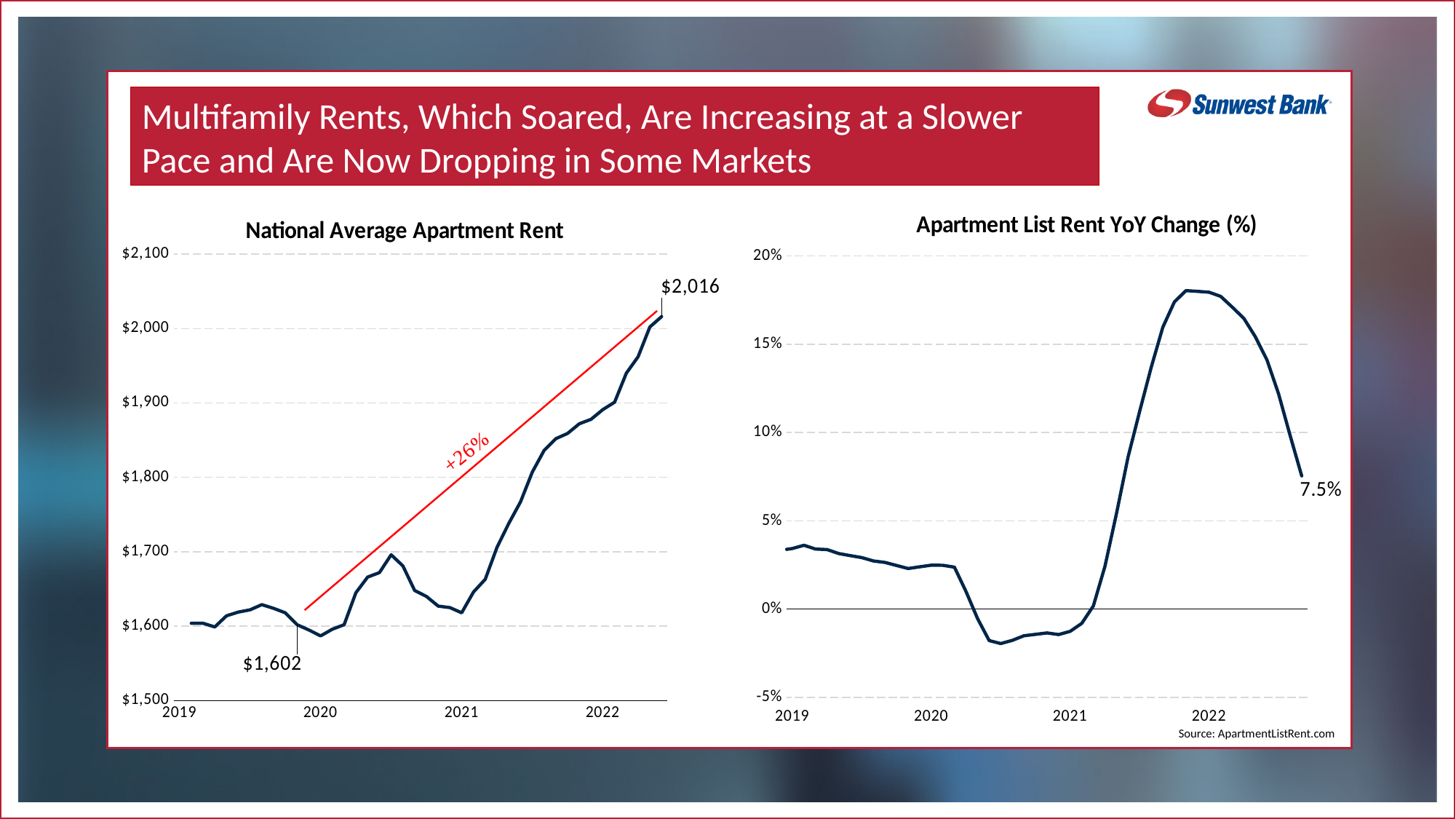
What kind of chart is the National Average Apartment Rent chart? line chart What kind of chart is the Apartment List Rent YoY Change (%) chart? line chart In the Apartment List Rent YoY Change (%) chart, is the peak value in 2022 greater or less than 15%? greater In the National Average Apartment Rent chart, what is the final labelled value at the end of the line in 2022? $2,016 In the Apartment List Rent YoY Change (%) chart, does the line rise or fall after its 2022 peak? fall In the National Average Apartment Rent chart, what percentage increase is written along the red trend line? +26% In the National Average Apartment Rent chart, does the line overall rise or fall from 2019 to 2022? rise In the Apartment List Rent YoY Change (%) chart, what is the labelled value at the end of the line? 7.5% In the National Average Apartment Rent chart, what is the difference between the labelled $2,016 value and the labelled $1,602 value? $414 In the National Average Apartment Rent chart, what is the labelled value of the low point near the start of 2020? $1,602 In the Apartment List Rent YoY Change (%) chart, is the lowest value in 2020 greater or less than 0%? less In the Apartment List Rent YoY Change (%) chart, is the value at the start of 2019 greater or less than 5%? less